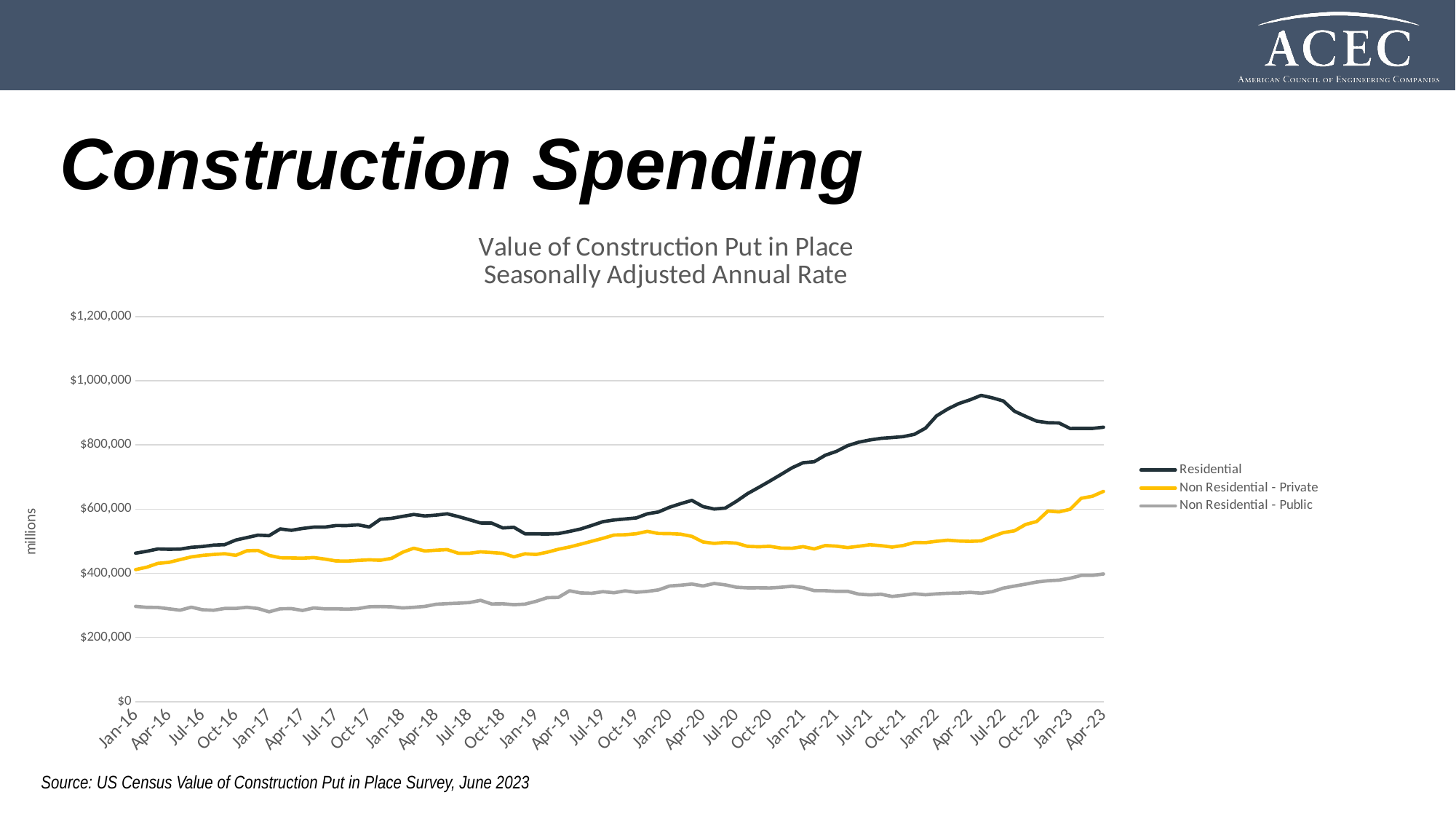
What are the three series listed in the chart's legend? Residential, Non Residential - Private, Non Residential - Public How many series does the chart's legend list? 3 Is the value for Non Residential - Public at Jan-16 greater or less than $400,000? less What is the title of the chart? Value of Construction Put in Place Seasonally Adjusted Annual Rate Which series has the highest values across the whole chart? Residential At Apr-23, which is larger: Residential or Non Residential - Private? Residential What kind of chart is shown on the slide? Line chart Is the value for Residential at Apr-22 greater or less than $800,000? greater Does the Residential series rise or fall from Jan-16 to Apr-22? Rise Which series has the lowest values across the whole chart? Non Residential - Public Is the value for Non Residential - Private at Apr-23 greater or less than $600,000? greater